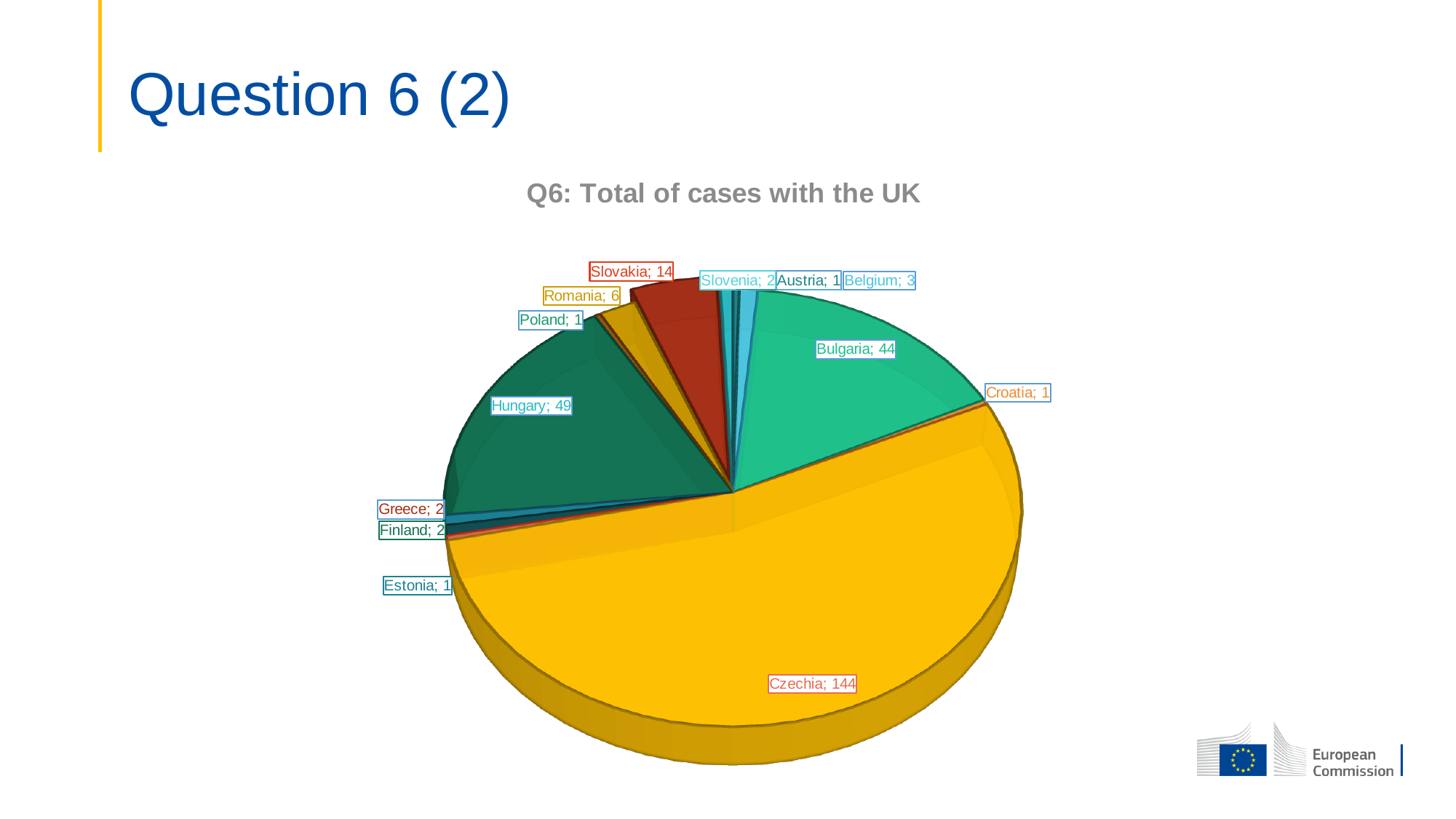
What is the title of the chart? Q6: Total of cases with the UK How many cases with the UK are shown for Czechia? 144 Which country has the largest slice of the pie? Czechia What is the difference between the values for Hungary and Bulgaria? 5 What is the value shown for Bulgaria? 44 What is the value shown for Hungary? 49 Which has a larger value, Slovakia or Romania? Slovakia How many countries are shown in the pie chart? 13 What is the value shown for Romania? 6 What type of chart is shown on the slide? Pie chart What is the value shown for Slovakia? 14 What is the difference between the values for Czechia and Hungary? 95